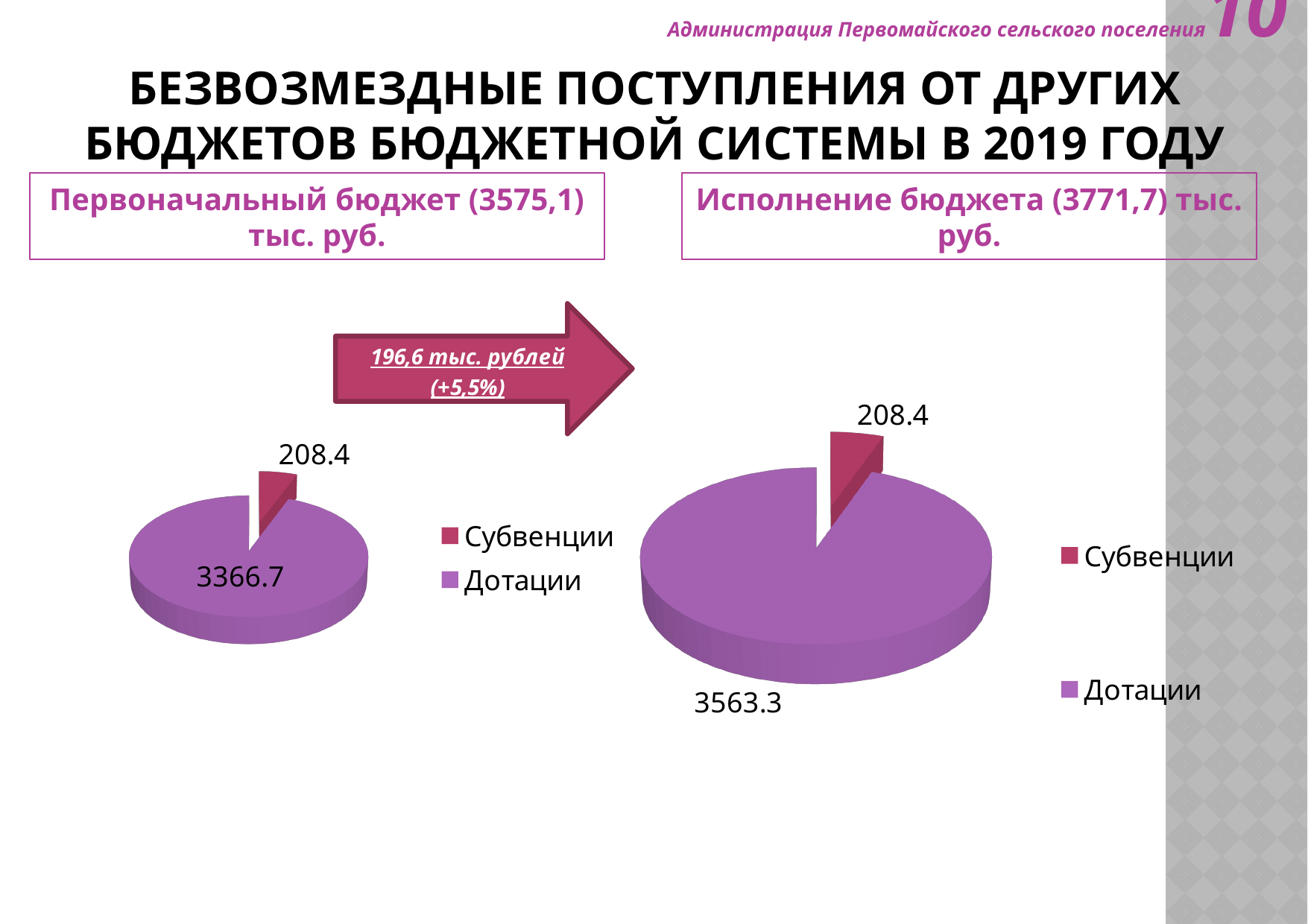
How many categories does the left chart (Первоначальный бюджет) show? 2 In the right chart (Исполнение бюджета), what colour is the Субвенции slice? red Is the value for Дотации larger in the left chart (Первоначальный бюджет) or in the right chart (Исполнение бюджета)? right chart (Исполнение бюджета) In the right chart (Исполнение бюджета), what is the difference between Дотации and Субвенции? 3354.9 What type of chart is the right chart (Исполнение бюджета)? pie chart In the left chart (Первоначальный бюджет), what is the difference between Дотации and Субвенции? 3158.3 In the right chart (Исполнение бюджета), what is the value for Субвенции? 208.4 In the right chart (Исполнение бюджета), which category has the smallest slice? Субвенции In the left chart (Первоначальный бюджет), what is the value for Дотации? 3366.7 In the left chart (Первоначальный бюджет), what is the value for Субвенции? 208.4 In the right chart (Исполнение бюджета), what is the value for Дотации? 3563.3 In the left chart (Первоначальный бюджет), which category has the largest slice? Дотации